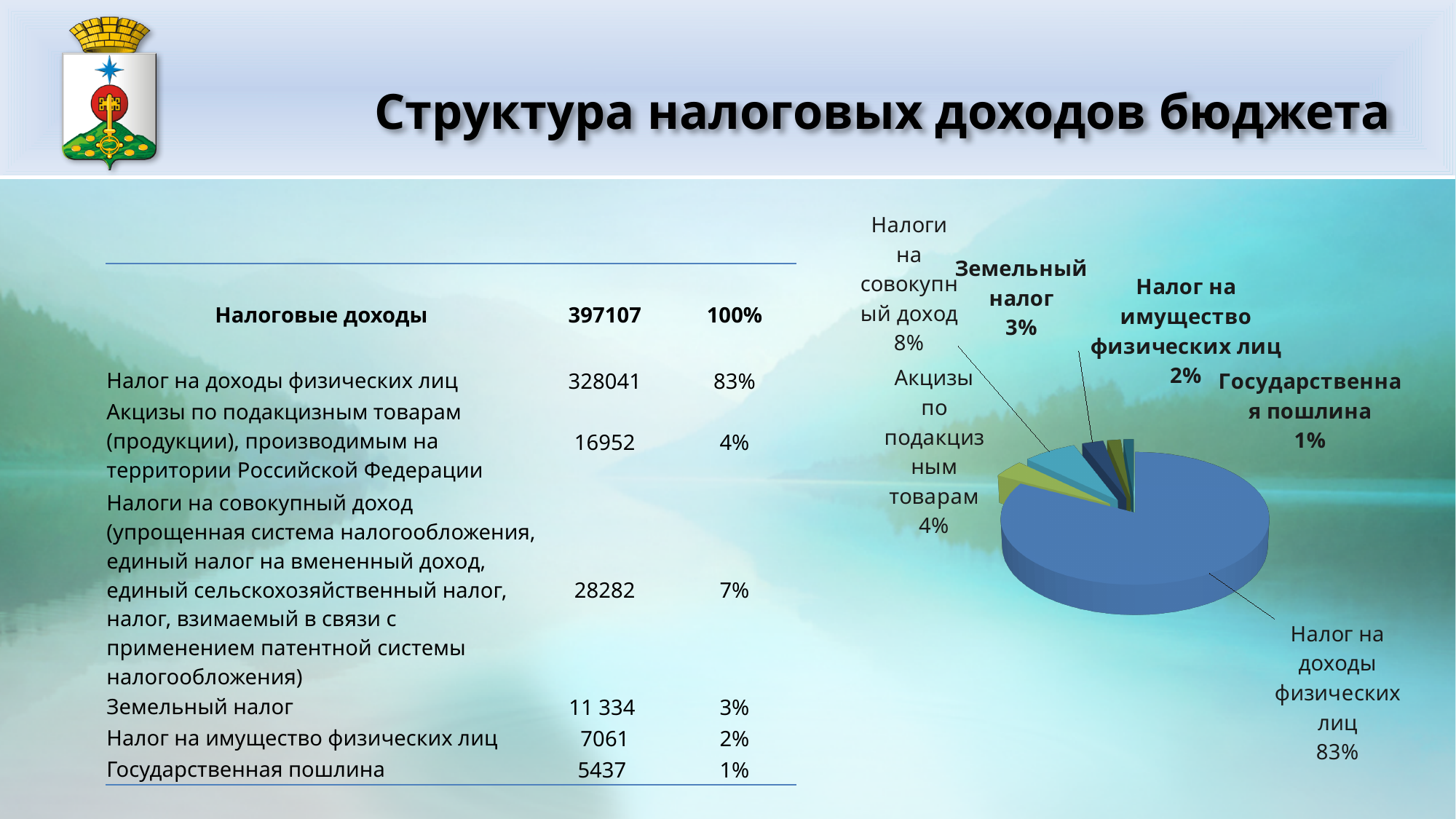
What share of the pie does "Налог на имущество физических лиц" have? 2% Which is larger in the pie chart: "Налоги на совокупный доход" or "Акцизы по подакцизным товарам"? Налоги на совокупный доход What share of the pie does "Акцизы по подакцизным товарам" have? 4% What share of the pie does "Государственная пошлина" have? 1% How many slices does the pie chart have? 6 What kind of chart is shown on the slide? Pie chart Which slice of the pie chart is the smallest? Государственная пошлина What is the difference in percentage points between the "Налог на доходы физических лиц" slice and the "Налоги на совокупный доход" slice? 75% Which slice of the pie chart is the largest? Налог на доходы физических лиц